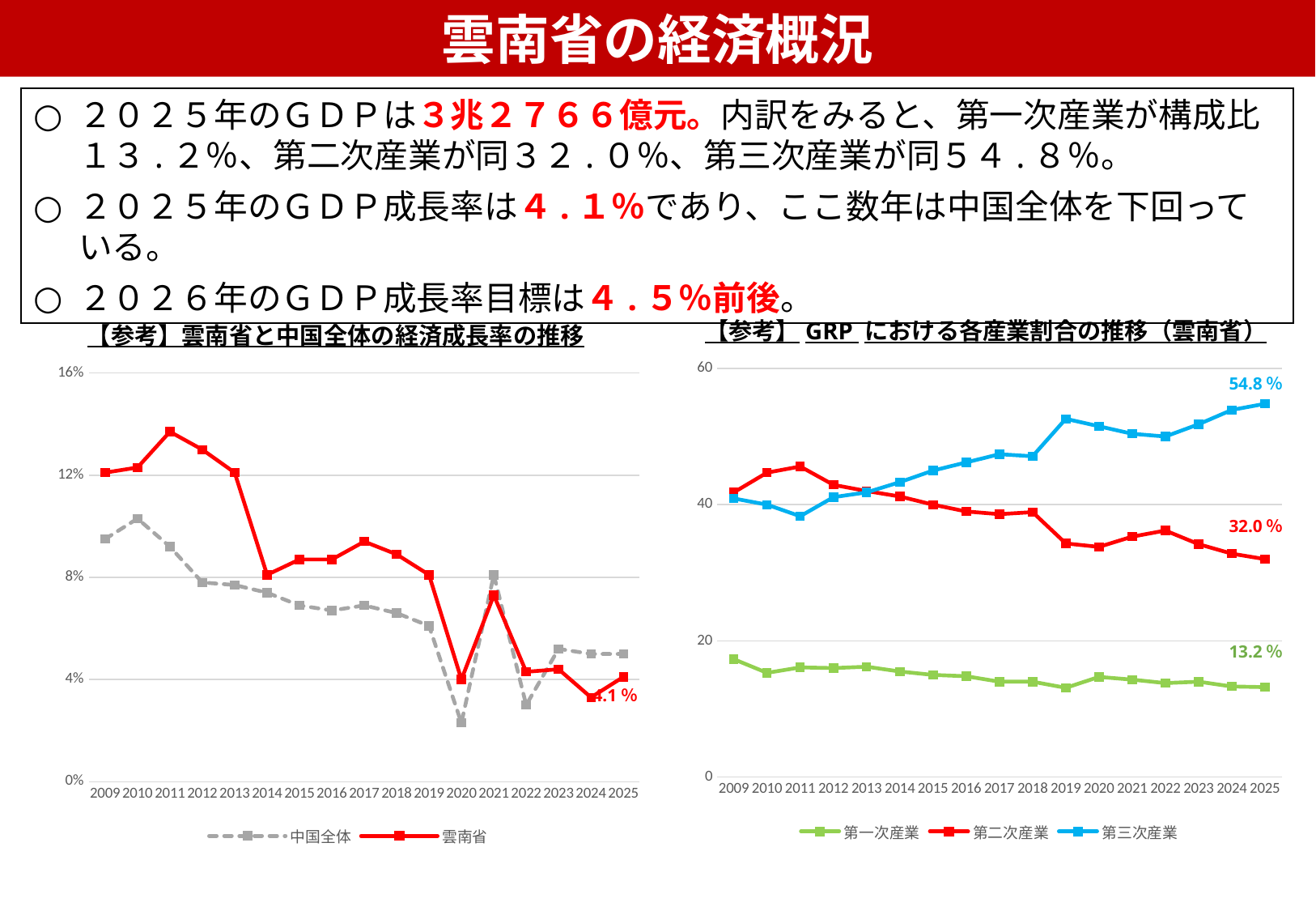
In the left chart (雲南省と中国全体の経済成長率の推移), what is the labelled value for 雲南省 in 2025? 4.1% What kind of chart is the left chart, 雲南省と中国全体の経済成長率の推移? line chart In the right chart (GRPにおける各産業割合の推移), which series has the highest value in 2025? 第三次産業 In the right chart (GRPにおける各産業割合の推移), how many years are shown on the x axis? 17 In the left chart (雲南省と中国全体の経済成長率の推移), is the value for 雲南省 in 2011 greater or less than 12%? greater In the right chart (GRPにおける各産業割合の推移), what is the difference between the 2025 values of 第三次産業 and 第二次産業? 22.8% In the left chart (雲南省と中国全体の経済成長率の推移), how many series does the legend list? 2 In the right chart (GRPにおける各産業割合の推移), what is the labelled value for 第三次産業 in 2025? 54.8% In the right chart (GRPにおける各産業割合の推移), does the 第三次産業 line generally rise or fall from 2009 to 2025? rise In the right chart (GRPにおける各産業割合の推移), what is the labelled value for 第二次産業 in 2025? 32.0% In the right chart (GRPにおける各産業割合の推移), how many series does the legend list? 3 In the right chart (GRPにおける各産業割合の推移), what is the labelled value for 第一次産業 in 2025? 13.2%